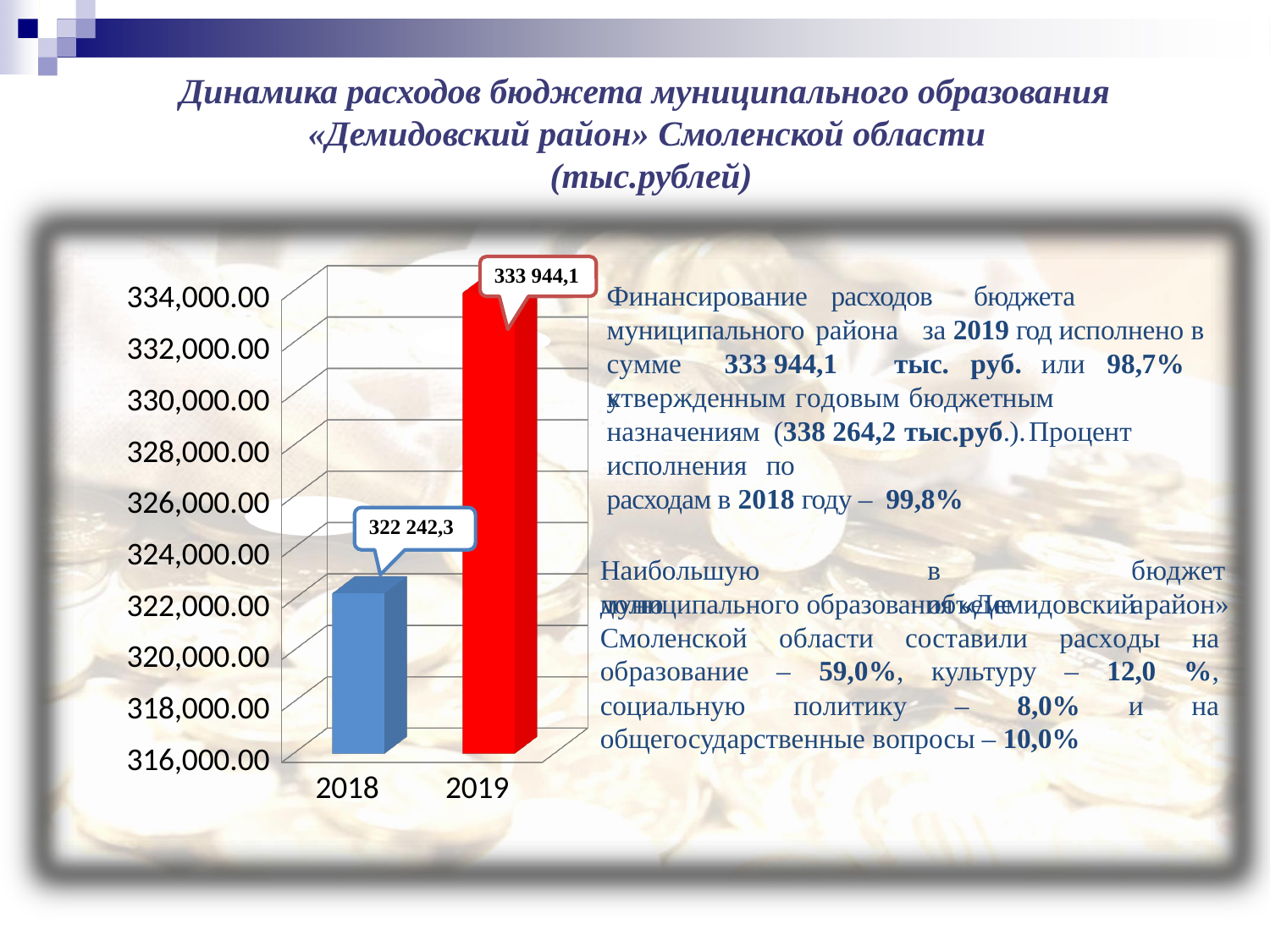
What colour is the bar for 2019? red What is the value shown for 2019? 333 944,1 Is the value for 2019 larger or smaller than the value for 2018? larger Is the value for 2019 greater or less than 332,000.00? greater What kind of chart is shown on the slide? bar chart Which year has the higher value? 2019 How many years are plotted on the chart? 2 By how much does the 2019 value exceed the 2018 value? 11 701,8 Which year has the lower value? 2018 Do the values rise or fall from 2018 to 2019? rise Is the value for 2018 greater or less than 324,000.00? less What is the value shown for 2018? 322 242,3